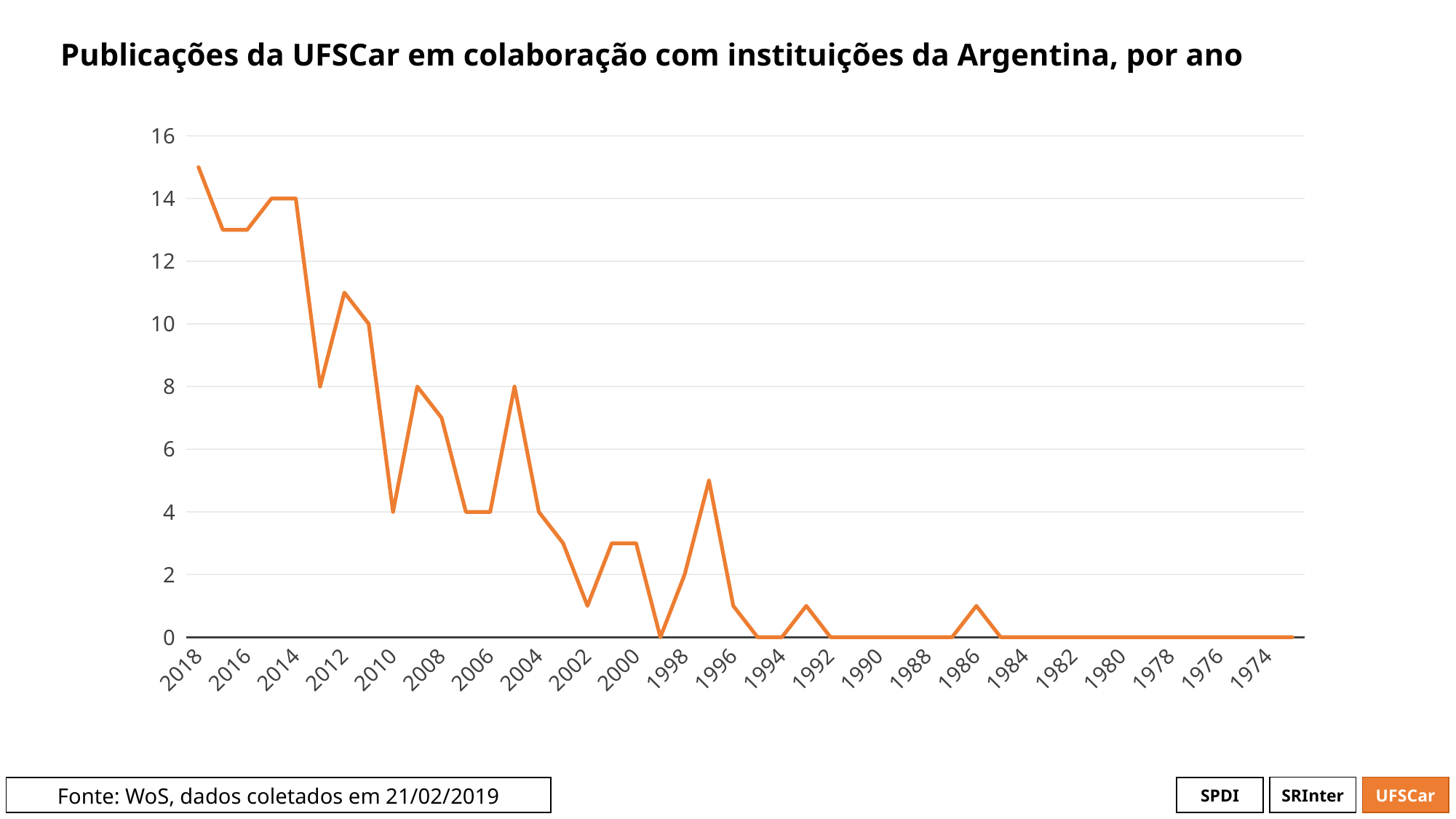
Is the value for 2002 greater or less than 2? less What is the value for 1988? 0 What is the value for 2010? 4 Is the value for 2018 greater or less than 14? greater What is the difference between the value for 2014 and the value for 2010? 10 Is the value for 2012 greater or less than 10? greater Which is larger, the value for 2014 or the value for 2010? 2014 What is the value for 1998? 2 What is the value for 2014? 14 Moving from left (2018) to right (1974) along the x axis, do the values generally rise or fall? fall Which year has the highest value? 2018 What kind of chart is shown on the slide? line chart